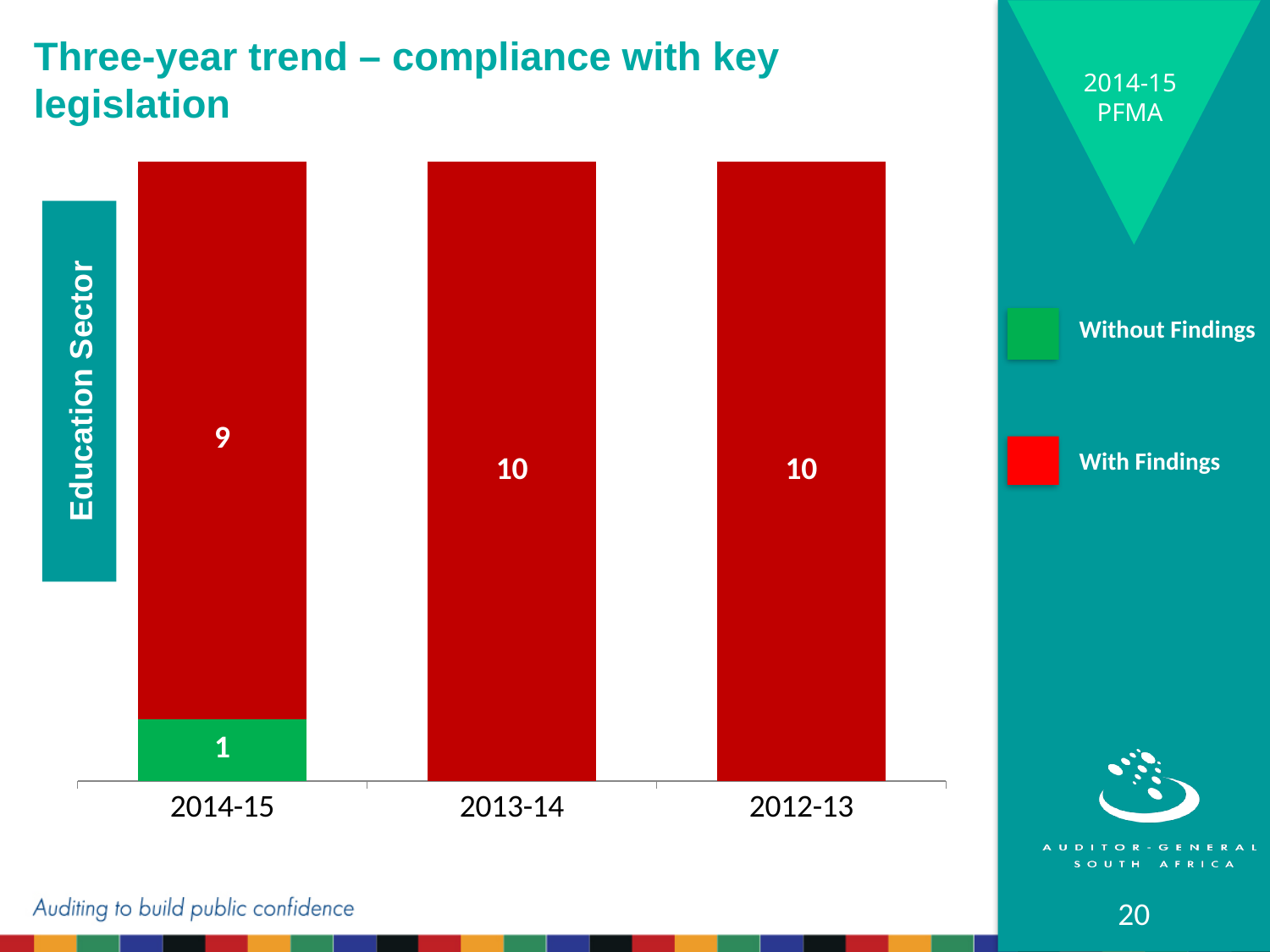
Which colour represents Without Findings in the legend? Green What is the value for With Findings in 2014-15? 9 Which year has the lowest With Findings value? 2014-15 How many series does the legend list? 2 What kind of chart is shown on the slide? Stacked bar chart What is the value for With Findings in 2012-13? 10 Which is larger, the With Findings value for 2012-13 or for 2014-15? 2012-13 What is the total of the stacked bar for 2014-15? 10 What is the value for With Findings in 2013-14? 10 How many years are shown on the x axis? 3 What is the difference between the With Findings values for 2013-14 and 2014-15? 1 What is the value for Without Findings in 2014-15? 1